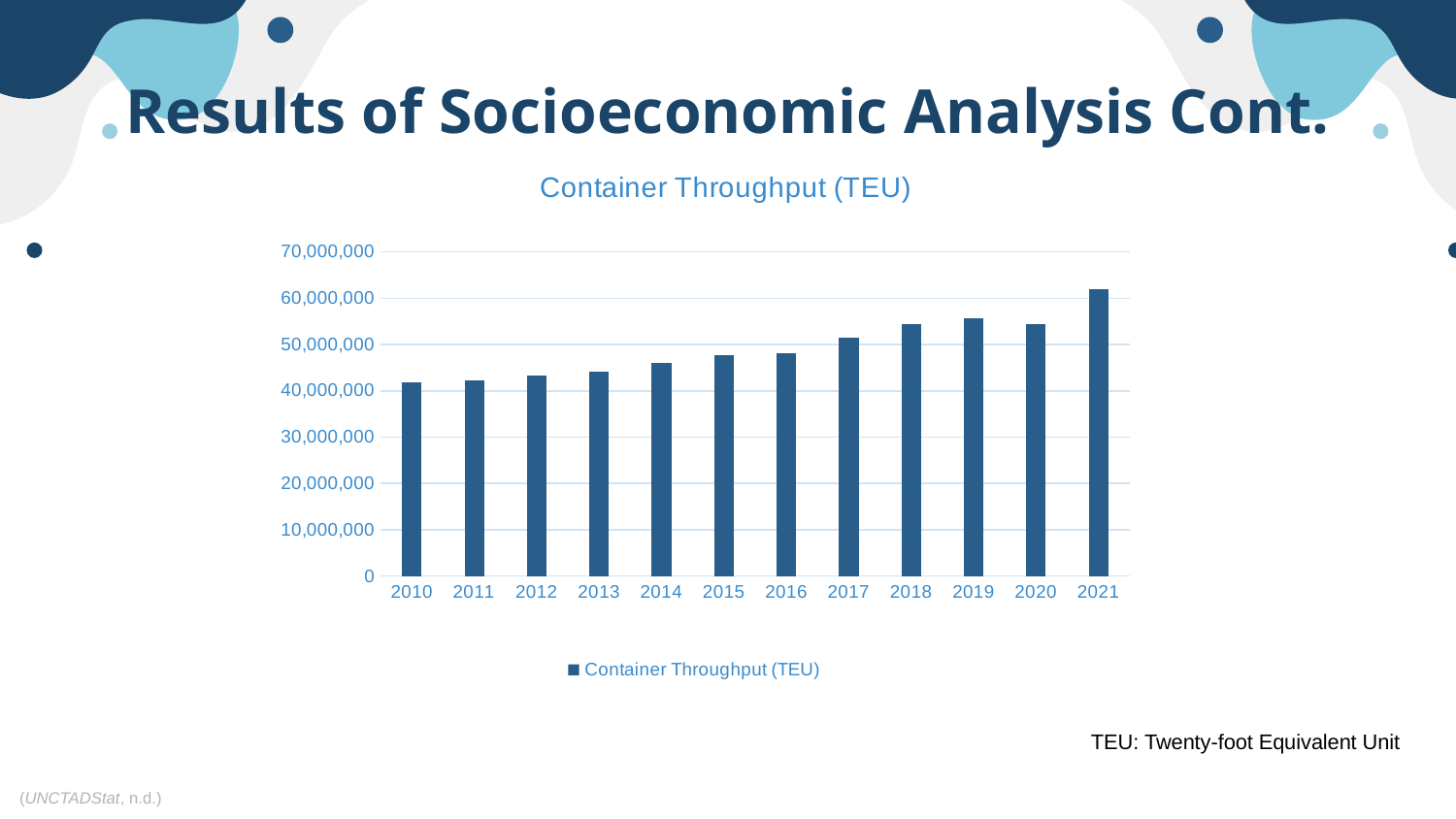
How many years are plotted on the x axis of the chart? 12 Is the container throughput for 2021 greater or less than 60,000,000? greater How many series does the chart's legend list? 1 Is the container throughput for 2010 greater or less than 50,000,000? less Which year has the lowest container throughput? 2010 Do the container throughput values generally rise or fall from 2010 to 2021? rise Which year has the larger container throughput, 2014 or 2018? 2018 What kind of chart is shown on the slide? bar chart What is the title of the chart? Container Throughput (TEU) Which year has the highest container throughput? 2021 Is the container throughput for 2017 greater or less than 50,000,000? greater What is the legend entry shown below the chart? Container Throughput (TEU)